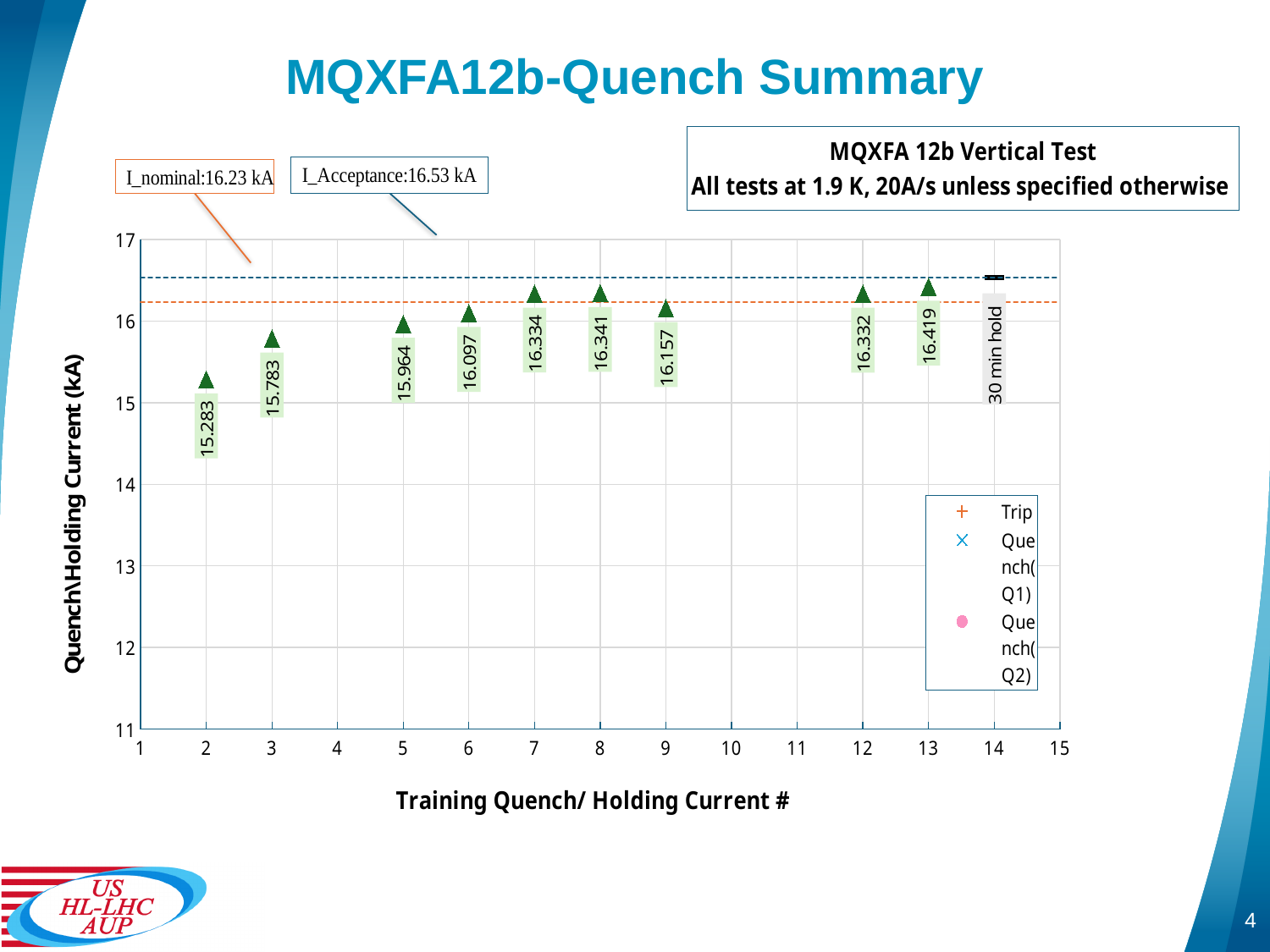
What is the quench current at training quench #9? 16.157 How many series does the legend list? 3 What value is given for I_nominal on the slide? 16.23 kA Is the quench current at training quench #3 greater or less than 16? less What is the label on the y axis of the chart? Quench\Holding Current (kA) What is the quench current at training quench #2? 15.283 Which training quench number has the highest labelled quench current? 13 Which is larger, the quench current at quench #5 or at quench #6? quench #6 How many labelled quench current values are plotted on the chart? 9 What is the difference between the quench current at quench #13 and at quench #2? 1.136 What is the quench current at training quench #13? 16.419 Which training quench number has the lowest labelled quench current? 2